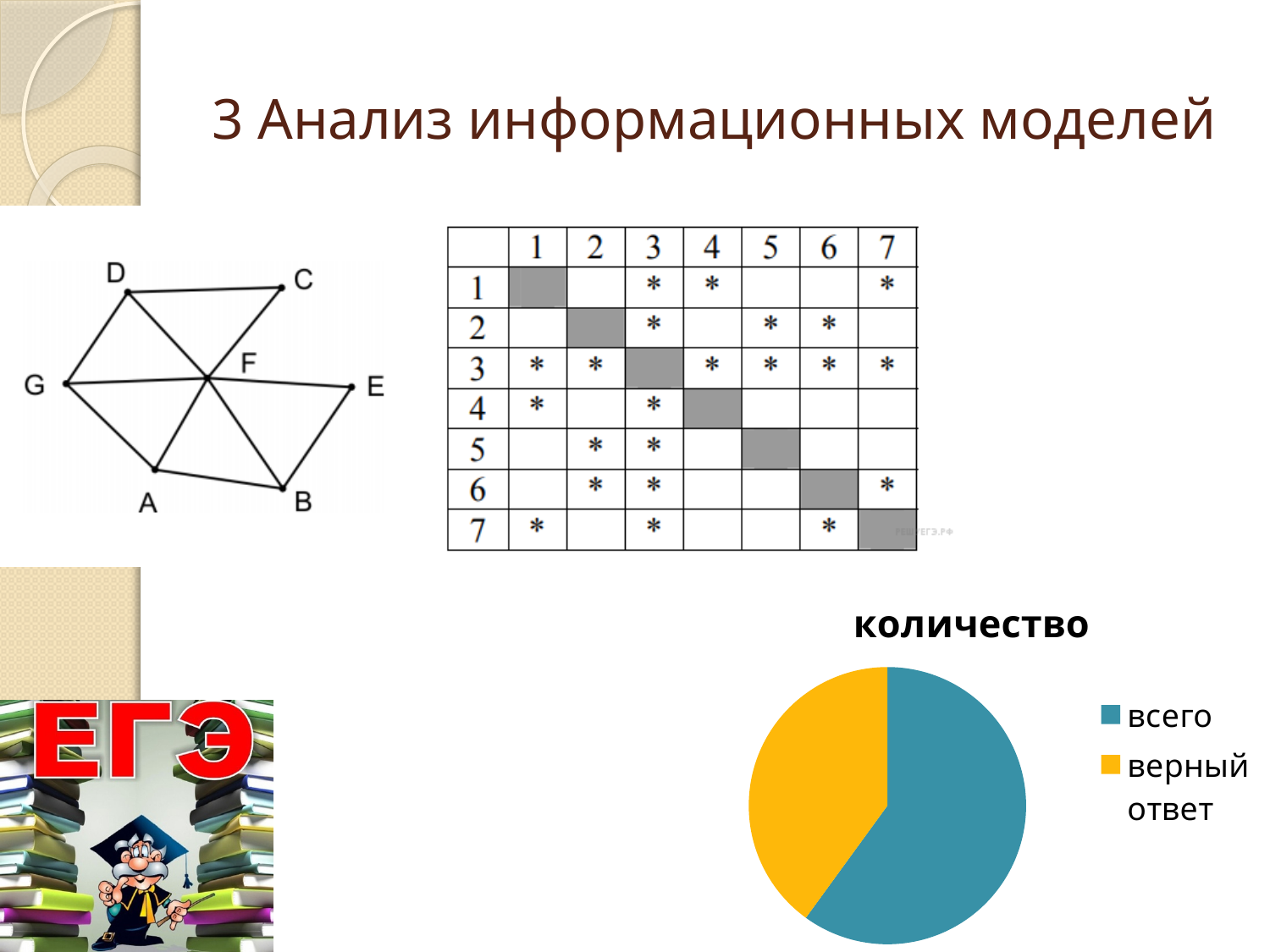
How many slices does the pie chart have? 2 What is the title of the pie chart? количество Does the slice for верный ответ take up more or less than half of the pie chart? less What kind of chart is shown at the bottom right of the slide? pie chart In the pie chart, which is larger: the slice for всего or the slice for верный ответ? всего Which slice of the pie chart is the largest? всего Which slice of the pie chart is the smallest? верный ответ What colour is the slice for верный ответ in the pie chart? yellow Does the slice for всего take up more or less than half of the pie chart? more How many entries does the legend of the pie chart list? 2